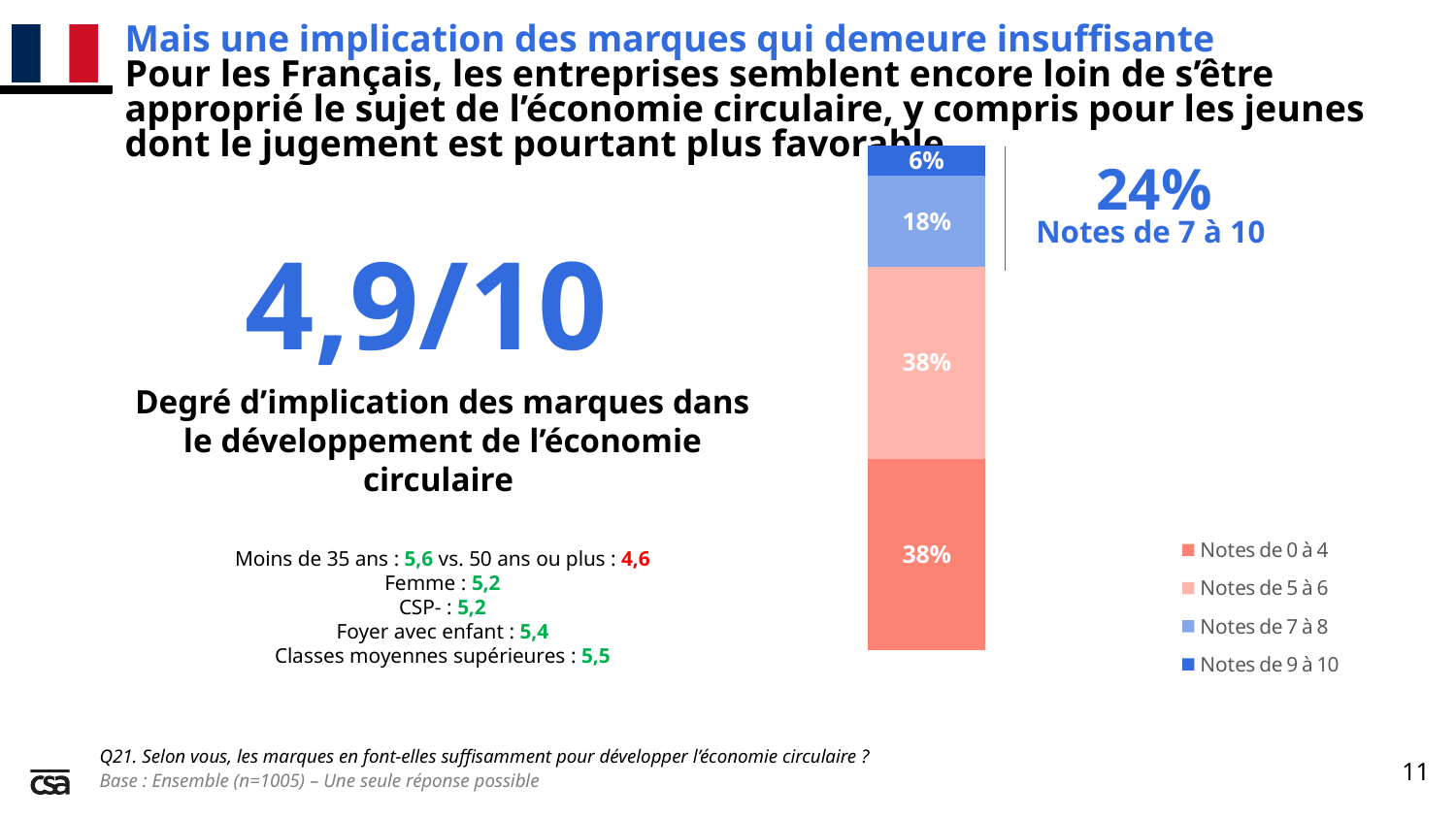
What percentage of respondents gave a score of 9 to 10 (Notes de 9 à 10)? 6% Which is larger: the share for Notes de 5 à 6 or the share for Notes de 7 à 8? Notes de 5 à 6 Which legend entry is shown in the darkest blue colour? Notes de 9 à 10 Which segment of the stacked bar is the smallest? Notes de 9 à 10 How many series does the legend list? 4 What kind of chart is shown on the slide? Stacked bar chart What is the total of the stacked bar? 100% What percentage of respondents gave a score of 7 to 8 (Notes de 7 à 8)? 18% What percentage of respondents gave a score of 5 to 6 (Notes de 5 à 6)? 38% What is the combined share for Notes de 7 à 8 and Notes de 9 à 10 (Notes de 7 à 10)? 24% What percentage of respondents gave a score of 0 to 4 (Notes de 0 à 4)? 38% What is the difference between the share for Notes de 7 à 8 and the share for Notes de 9 à 10? 12%